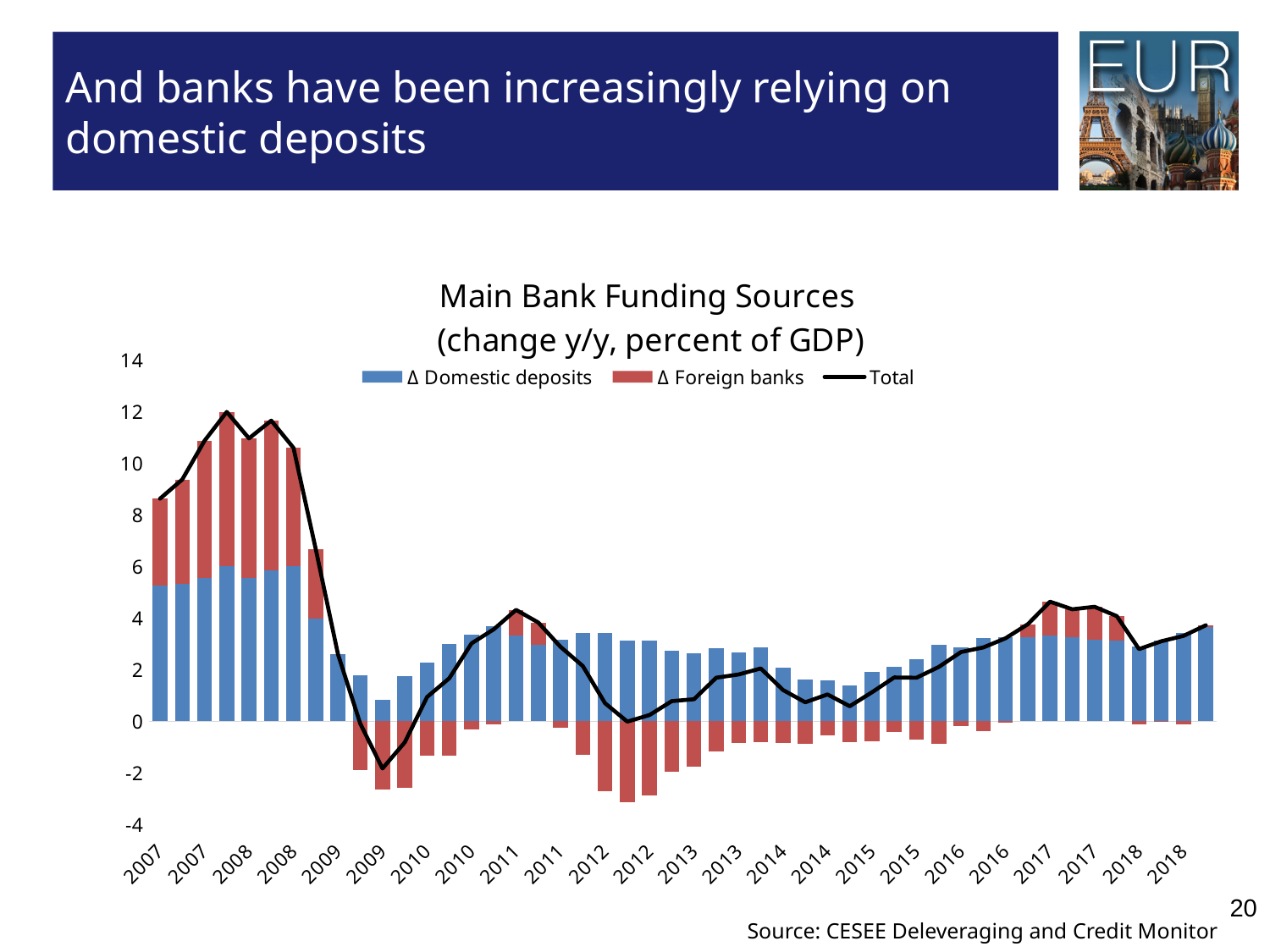
Is the lowest Total value in 2009 greater or less than 0? less Which colour represents Δ Domestic deposits? Blue What kind of chart is shown on the slide? Bar chart with a line How many series does the legend list? 3 What are the three series listed in the legend? Δ Domestic deposits, Δ Foreign banks, Total Which is larger, the Total value in 2008 or the Total value in 2018? 2008 Is the Total value at the start of 2007 greater or less than 8? greater In which year does the Total line reach its lowest point? 2009 Is the peak Total value in 2017 greater or less than 4? greater In which year does the Total line reach its highest point? 2007 Does the Total line rise or fall between 2008 and 2009? Fall